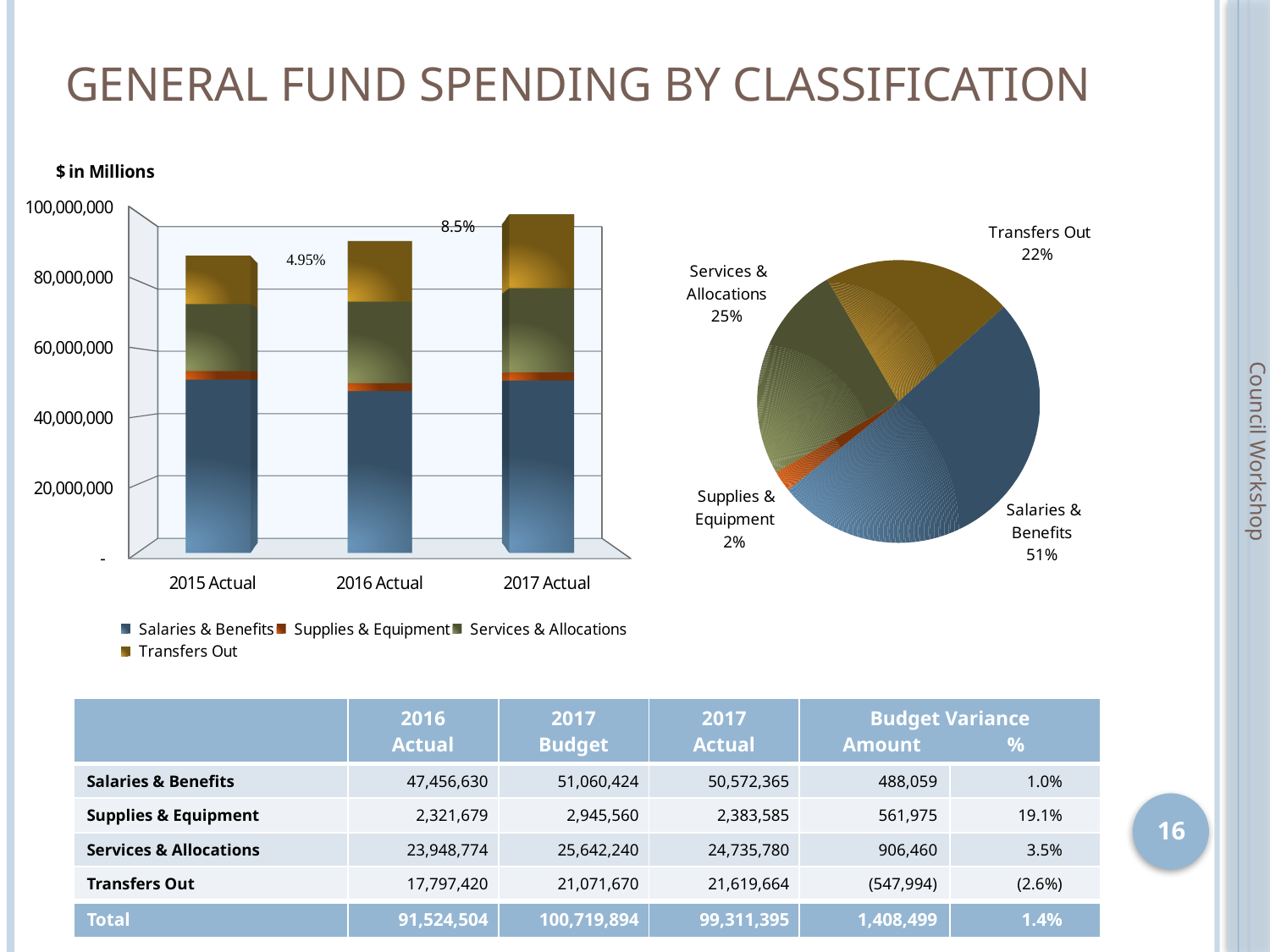
In the pie chart, what share does Salaries & Benefits represent? 51% How many series does the legend of the stacked bar chart on the left list? 4 What kind of chart is the chart on the left of the slide? Stacked bar chart What percentage label is shown above the 2017 Actual bar in the stacked bar chart on the left? 8.5% In the pie chart, what share does Transfers Out represent? 22% In the pie chart, which classification has the smallest share? Supplies & Equipment How many categories are shown on the x axis of the stacked bar chart on the left? 3 In the pie chart, which is larger: the Services & Allocations share or the Transfers Out share? Services & Allocations In the pie chart, which classification has the largest share? Salaries & Benefits In the pie chart, what is the difference in percentage points between the Salaries & Benefits share and the Transfers Out share? 29 In the stacked bar chart on the left, is the total for 2017 Actual greater or less than 80,000,000? greater In the stacked bar chart on the left, do the total bar heights rise or fall from 2015 Actual to 2017 Actual? Rise